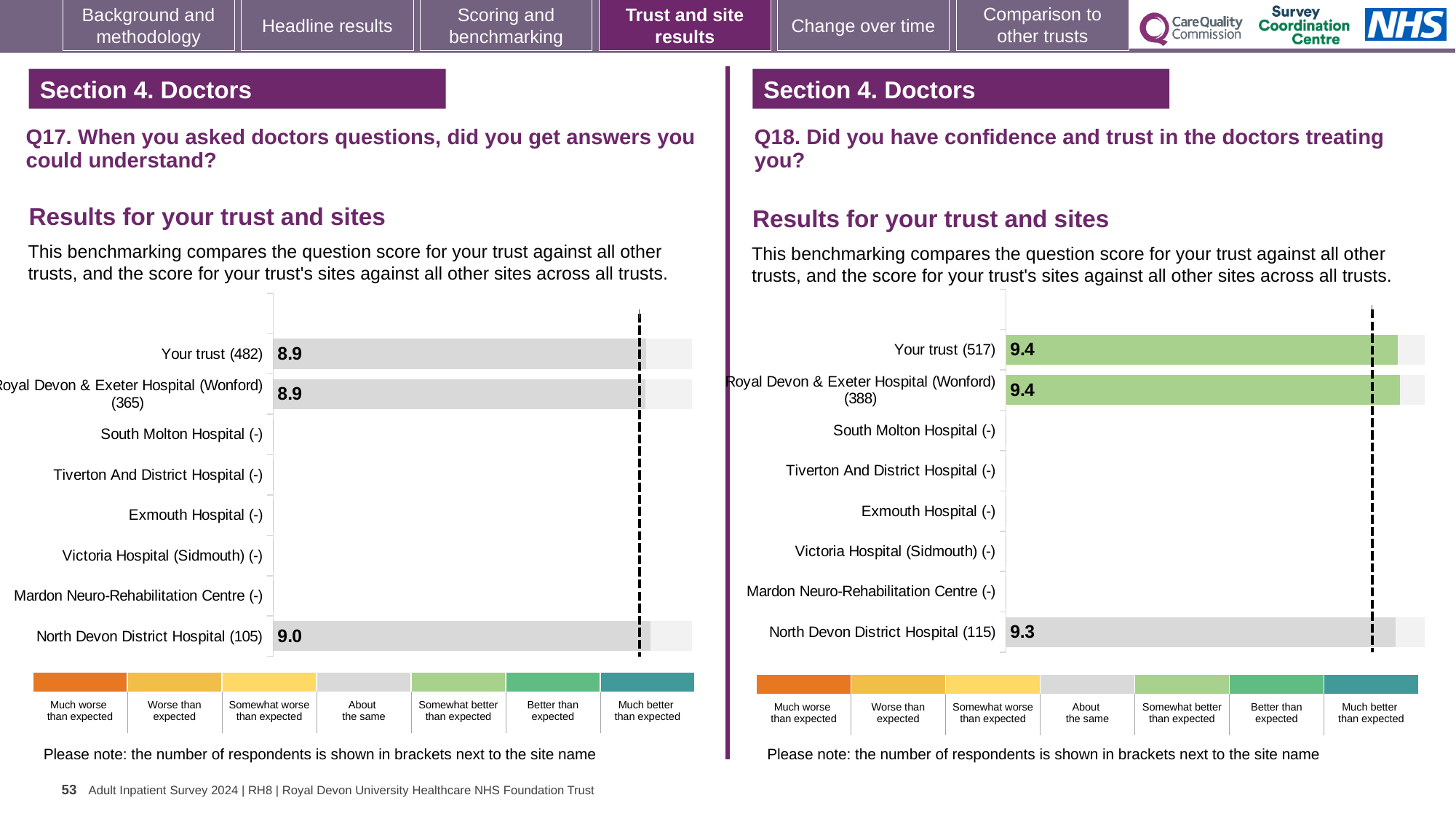
On the Q18 chart (right), what is the score for North Devon District Hospital (115)? 9.3 On the Q17 chart (left), what benchmark category does the grey colour of the bars represent? About the same How many categories (rows) are listed on the Q17 chart (left)? 8 On the Q18 chart (right), which is larger: the score for Royal Devon & Exeter Hospital (Wonford) (388) or the score for North Devon District Hospital (115)? Royal Devon & Exeter Hospital (Wonford) (388) On the Q18 chart (right), what benchmark category does the green colour of the Your trust (517) bar represent? Somewhat better than expected On the Q18 chart (right), which of the labelled sites has the lowest score? North Devon District Hospital (115) On the Q17 chart (left), what is the score for North Devon District Hospital (105)? 9.0 What kind of chart is used on the Q18 chart (right)? Bar chart On the Q18 chart (right), what is the score for Your trust (517)? 9.4 On the Q17 chart (left), which site has the highest score? North Devon District Hospital (105) On the Q17 chart (left), what is the difference between the score for North Devon District Hospital (105) and the score for Your trust (482)? 0.1 On the Q17 chart (left), what is the score for Your trust (482)? 8.9